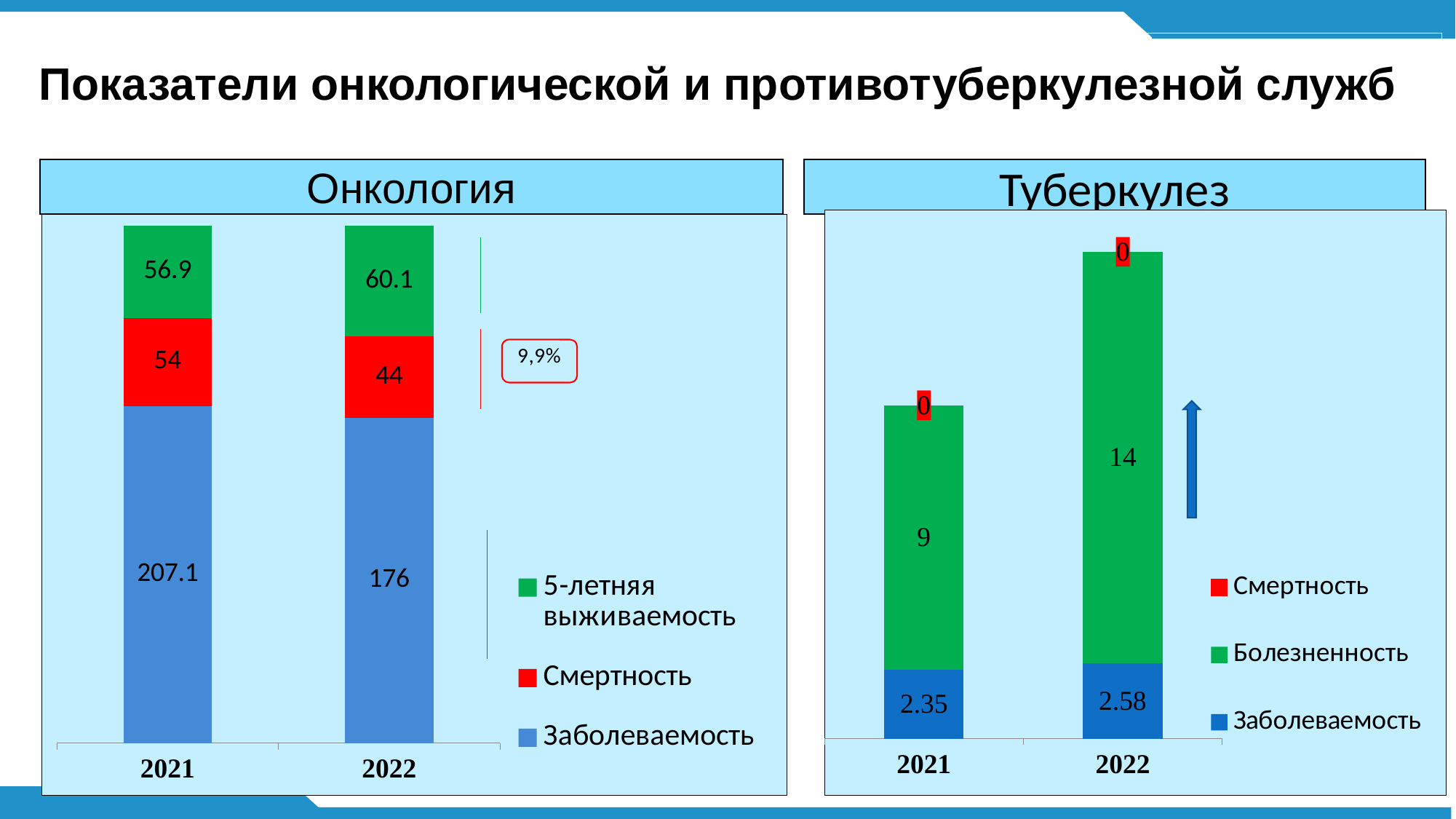
In the Онкология chart, what is the difference between Заболеваемость in 2021 and 2022? 31.1 In the Онкология chart, what is the value of 5-летняя выживаемость for 2022? 60.1 In the Онкология chart, what is the value of Смертность for 2022? 44 In the Онкология chart, what is the total of the stacked bar for 2022? 280.1 How many series does the legend of the Туберкулез chart list? 3 In the Туберкулез chart, what is the total of the stacked bar for 2021? 11.35 In the Онкология chart, what is the value of Заболеваемость for 2021? 207.1 What kind of chart is the Онкология chart? stacked bar chart In the Туберкулез chart, which year has the higher Болезненность value, 2021 or 2022? 2022 In the Туберкулез chart, what is the value of Болезненность for 2022? 14 In the Туберкулез chart, what is the value of Заболеваемость for 2021? 2.35 In the Онкология chart, does Смертность rise or fall from 2021 to 2022? fall